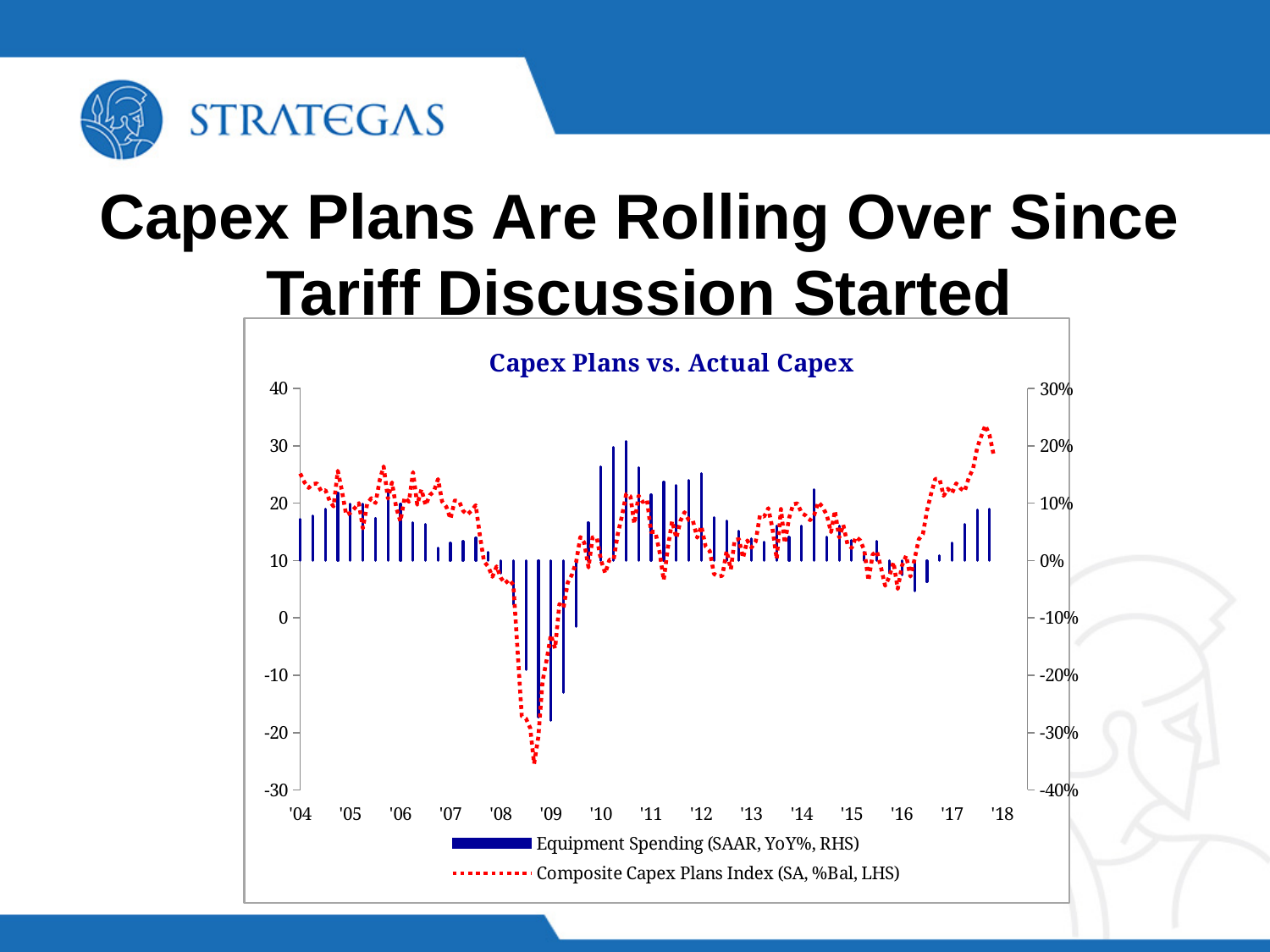
Does the Composite Capex Plans Index rise or fall between 2016 and early 2018? rise Which series is plotted as blue bars? Equipment Spending (SAAR, YoY%, RHS) Is the peak value of the Composite Capex Plans Index in 2018 greater or less than 30? greater Does the Composite Capex Plans Index rise or fall between 2008 and early 2009? fall Is the lowest value of the Composite Capex Plans Index in 2009 greater or less than -20? less What kind of chart is shown on the slide? A combined bar and line chart How many series does the chart's legend list? 2 In which year does the Composite Capex Plans Index reach its lowest point? '09 Is the lowest Equipment Spending bar in 2009 greater or less than -20%? less What is the title of the chart? Capex Plans vs. Actual Capex How many year labels are shown on the x axis? 15 In which year does the Composite Capex Plans Index reach its highest point? '18